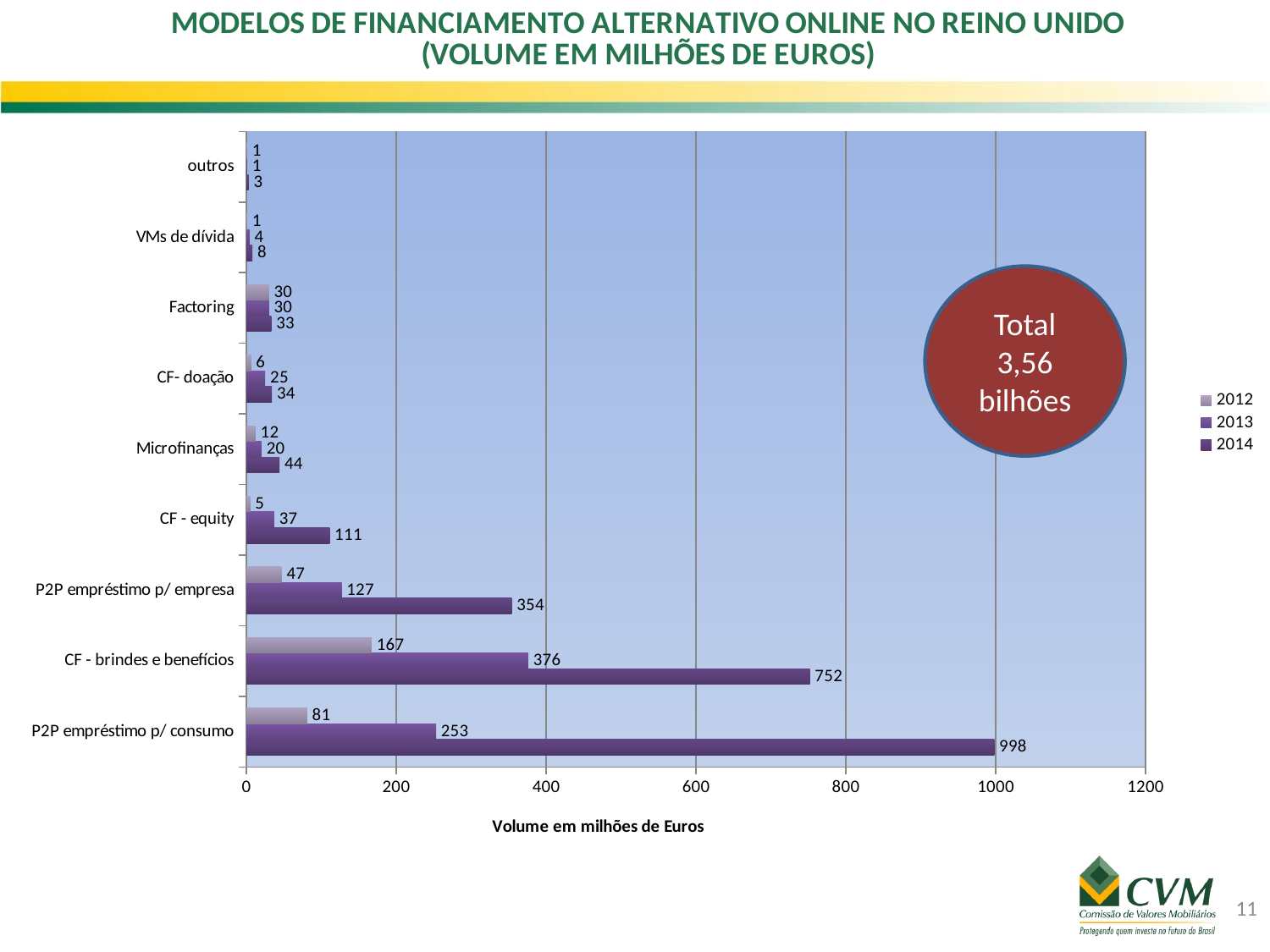
How many series does the legend list? 3 Which category has the highest 2014 value? P2P empréstimo p/ consumo What is the 2013 value for CF - brindes e benefícios? 376 What is the 2014 value for P2P empréstimo p/ consumo? 998 What is the difference between the 2014 and 2013 values for CF - brindes e benefícios? 376 What kind of chart is shown on the slide? bar chart How many categories are shown on the y axis? 9 What total is shown in the circle on the chart? 3,56 bilhões Which category has the lowest 2014 value? outros What is the 2012 value for P2P empréstimo p/ empresa? 47 Which is larger: the 2014 value for CF - equity or the 2013 value for P2P empréstimo p/ empresa? 2013 value for P2P empréstimo p/ empresa Is the 2014 value for CF - brindes e benefícios greater or less than 600? greater